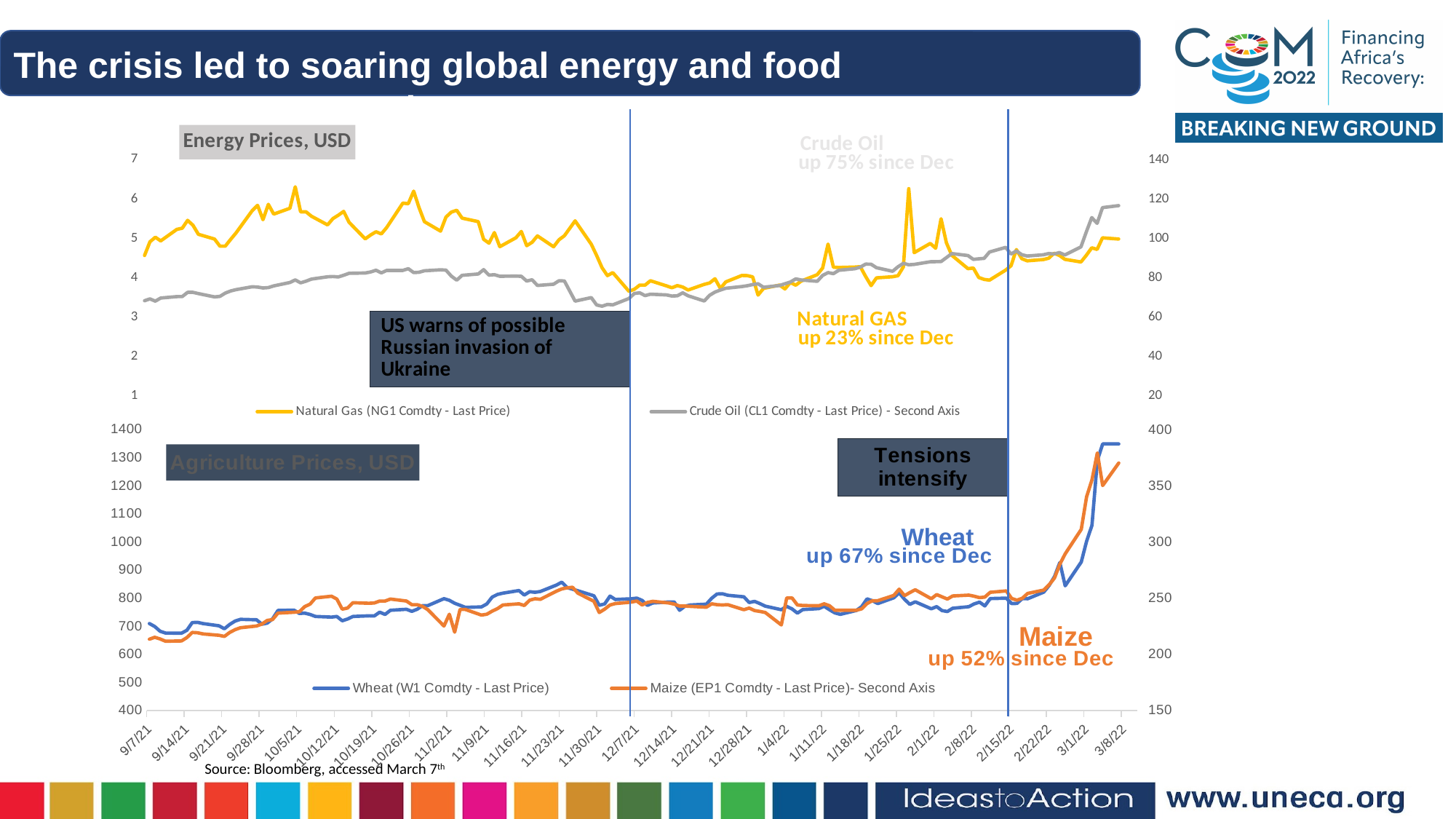
In the Agriculture Prices, USD chart, is the Maize value on 3/8/22 (second axis) greater or less than 350? greater In the Agriculture Prices, USD chart, what is the difference in percentage points between the Wheat and Maize increases since December? 15 percentage points How many series does the legend of the Agriculture Prices, USD chart list? 2 In the Energy Prices, USD chart, by what percentage has Natural Gas risen since December according to the annotation? up 23% since Dec In the Energy Prices, USD chart, is the Crude Oil value on 3/8/22 (second axis) greater or less than 100? greater What kind of chart is the Energy Prices, USD chart? Line chart In the Agriculture Prices, USD chart, does the Wheat price rise or fall between 2/15/22 and 3/8/22? Rises In the Agriculture Prices, USD chart, by what percentage has Wheat risen since December according to the annotation? up 67% since Dec In the Agriculture Prices, USD chart, by what percentage has Maize risen since December according to the annotation? up 52% since Dec In the Energy Prices, USD chart, which colour is used for the Natural Gas line? Yellow In the Energy Prices, USD chart, by what percentage has Crude Oil risen since December according to the annotation? up 75% since Dec In the Energy Prices, USD chart, which commodity shows the larger percentage increase since December, Crude Oil or Natural Gas? Crude Oil